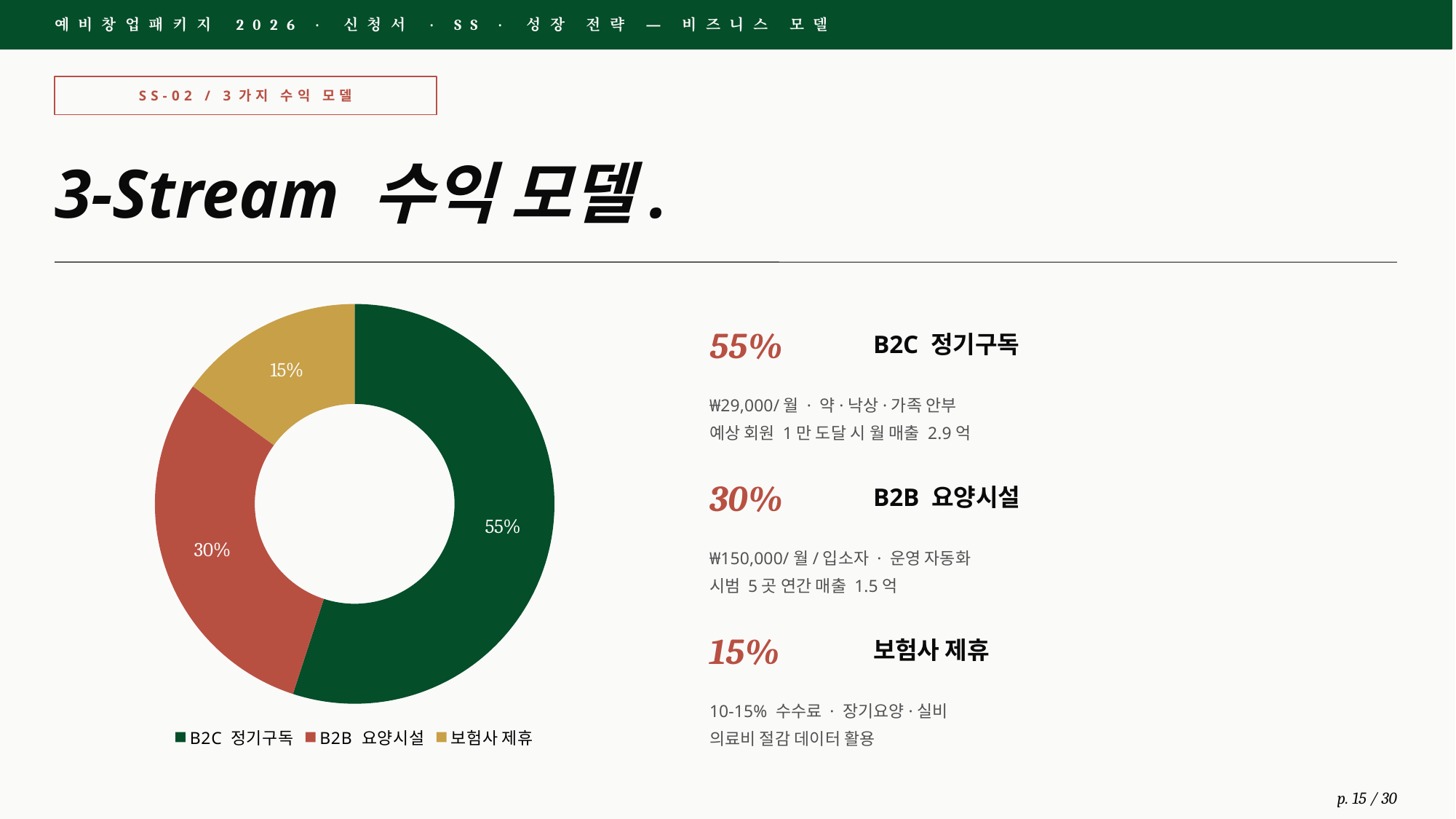
How many entries does the legend list? 3 Which is larger, the slice for B2B 요양시설 or the slice for 보험사 제휴? B2B 요양시설 What share of the pie does 보험사 제휴 have? 15% Which category has the largest slice of the pie? B2C 정기구독 What is the difference in percentage points between B2B 요양시설 and 보험사 제휴? 15 What colour is the slice for B2B 요양시설? Red What is the difference in percentage points between B2C 정기구독 and B2B 요양시설? 25 What kind of chart is shown on the slide? Pie chart (doughnut) How many slices does the pie chart have? 3 What share of the pie does B2B 요양시설 have? 30% Which category has the smallest slice of the pie? 보험사 제휴 What share of the pie does B2C 정기구독 have? 55%